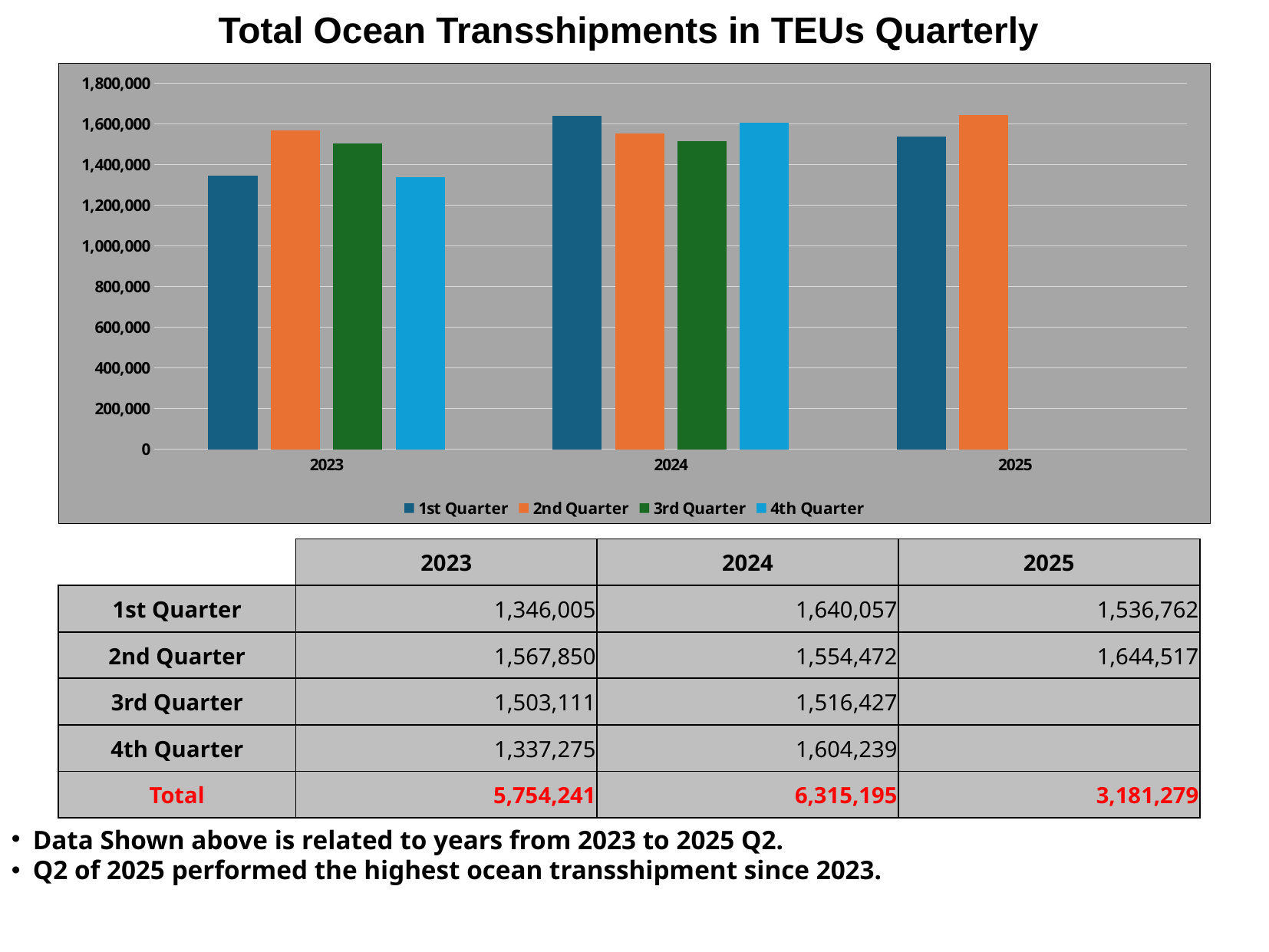
How many year categories are shown on the x axis? 3 How many series does the legend list? 4 What is the 1st Quarter value for 2024? 1,640,057 Which is larger, the 4th Quarter value for 2024 or the 2nd Quarter value for 2024? 4th Quarter 2024 What is the difference between the 1st Quarter values for 2024 and 2023? 294,052 What is the 4th Quarter value for 2023? 1,337,275 What is the 2nd Quarter value for 2025? 1,644,517 Is the 1st Quarter value for 2023 greater or less than 1,400,000? less What is the total of all quarters for 2024? 6,315,195 What type of chart is shown on the slide? bar chart Which quarter has the lowest value in 2024? 3rd Quarter Which quarter has the highest value in 2023? 2nd Quarter